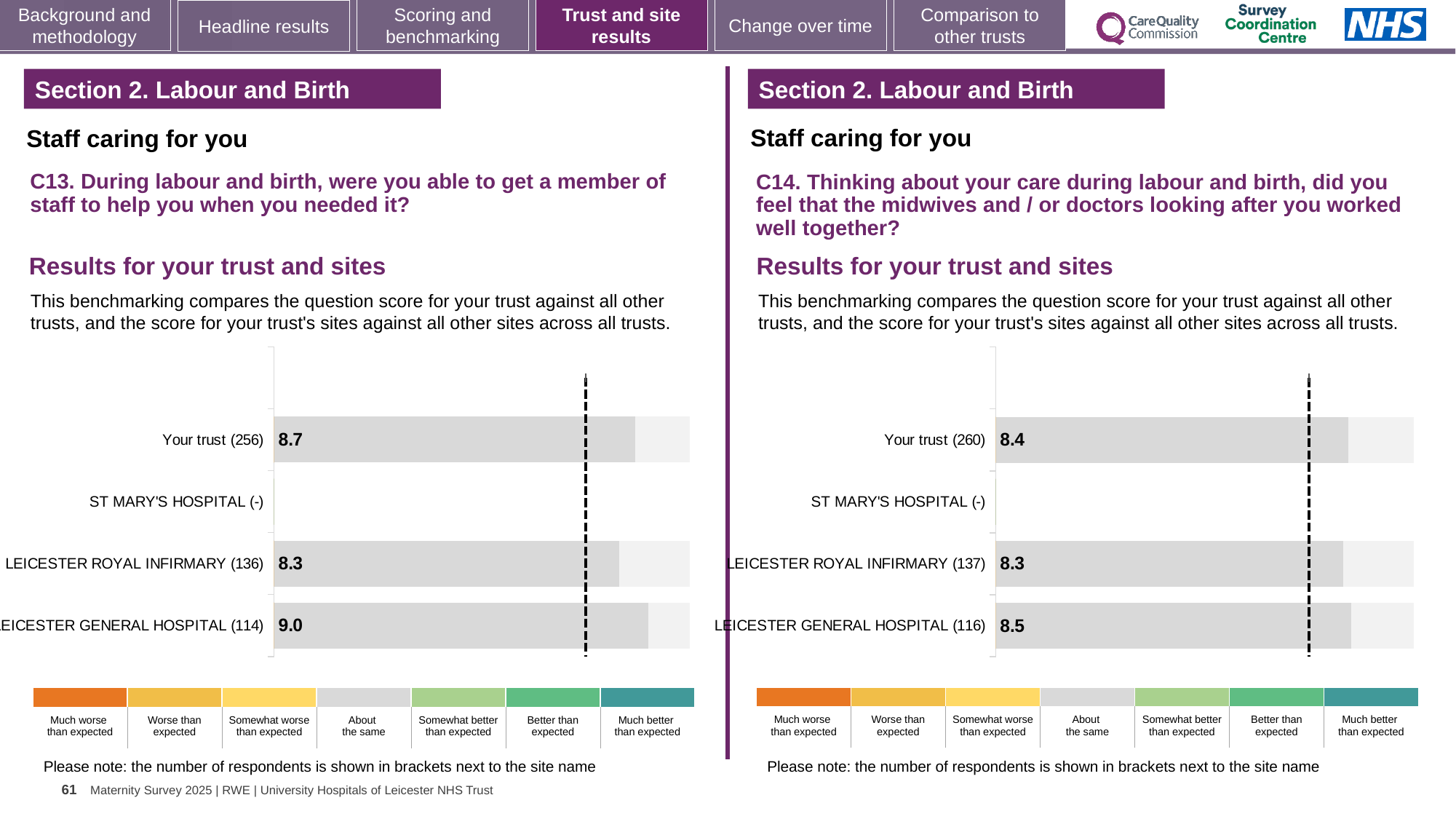
In the C14 chart on the right, what is the score for Your trust (260)? 8.4 How many rows (trust and sites) are listed in the C13 chart on the left? 4 In the C13 chart on the left, which site has the highest score? LEICESTER GENERAL HOSPITAL (114) In the C14 chart on the right, what is the score for LEICESTER ROYAL INFIRMARY (137)? 8.3 In the C14 chart on the right, which is larger: the score for Your trust (260) or for LEICESTER GENERAL HOSPITAL (116)? LEICESTER GENERAL HOSPITAL (116) What type of chart is used in the C13 chart on the left? Bar chart In the C13 chart on the left, what is the score for Your trust (256)? 8.7 In the C13 chart on the left, what is the difference between the scores for LEICESTER GENERAL HOSPITAL (114) and LEICESTER ROYAL INFIRMARY (136)? 0.7 In the C13 chart on the left, what is the score for LEICESTER GENERAL HOSPITAL (114)? 9.0 In the C14 chart on the right, which row has the lowest score shown? LEICESTER ROYAL INFIRMARY (137) In the C14 chart on the right, what is the difference between the scores for LEICESTER GENERAL HOSPITAL (116) and Your trust (260)? 0.1 In the C13 chart on the left, which site has no score bar shown? ST MARY'S HOSPITAL (-)